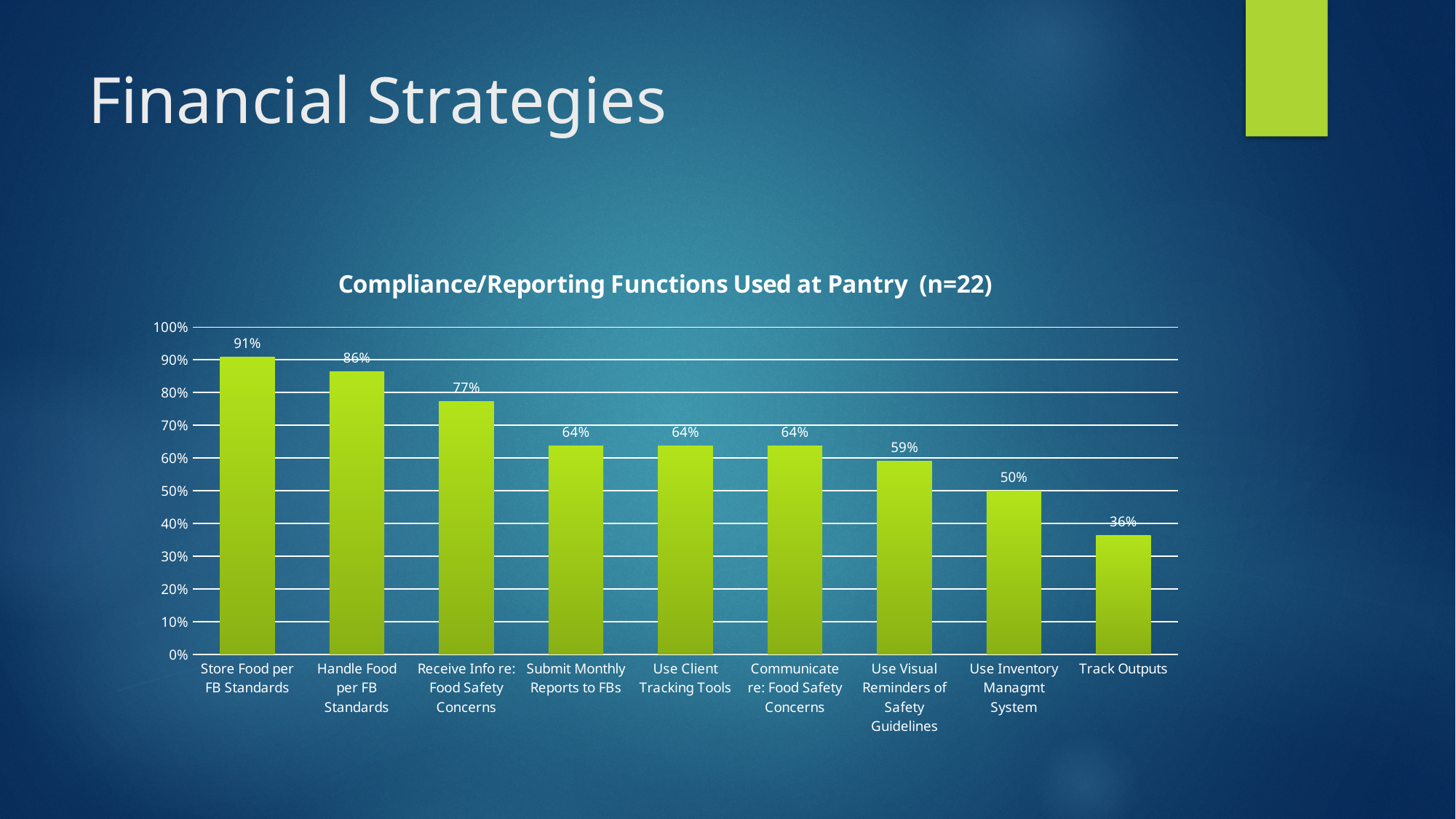
What is the difference between Handle Food per FB Standards and Receive Info re: Food Safety Concerns? 9% Which is larger, Use Client Tracking Tools or Track Outputs? Use Client Tracking Tools How many categories are shown in the chart? 9 What is the value for Use Visual Reminders of Safety Guidelines? 59% What is the value for Store Food per FB Standards? 91% Which category has the highest value? Store Food per FB Standards What kind of chart is shown on the slide? Bar chart Do the values rise or fall from left to right along the x axis? Fall What is the title of the chart? Compliance/Reporting Functions Used at Pantry (n=22) Is the value for Track Outputs greater or less than 40%? less What is the value for Use Inventory Managmt System? 50% Which category has the lowest value? Track Outputs